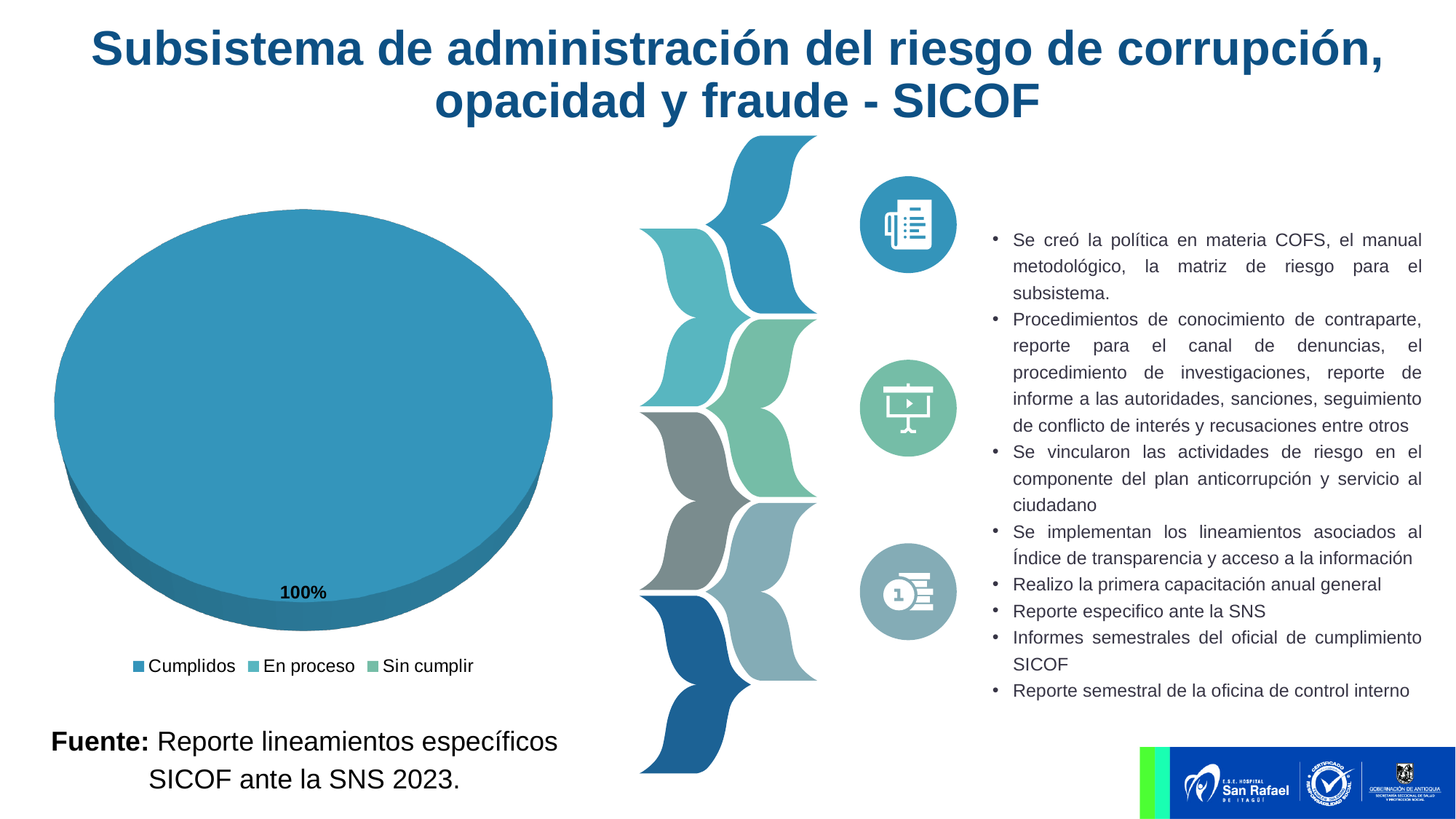
Is the share for Cumplidos greater or less than 50%? greater What are the three entries listed in the legend of the pie chart? Cumplidos, En proceso, Sin cumplir How many slices are visible in the pie chart? 1 What kind of chart is shown on the slide? pie chart How many entries does the legend of the pie chart list? 3 What is the source cited below the pie chart? Reporte lineamientos específicos SICOF ante la SNS 2023. Which category has the largest share in the pie chart? Cumplidos What share of the pie does the Cumplidos slice represent? 100% Which legend category does the single visible slice of the pie chart belong to? Cumplidos What percentage is printed on the pie chart's slice? 100%